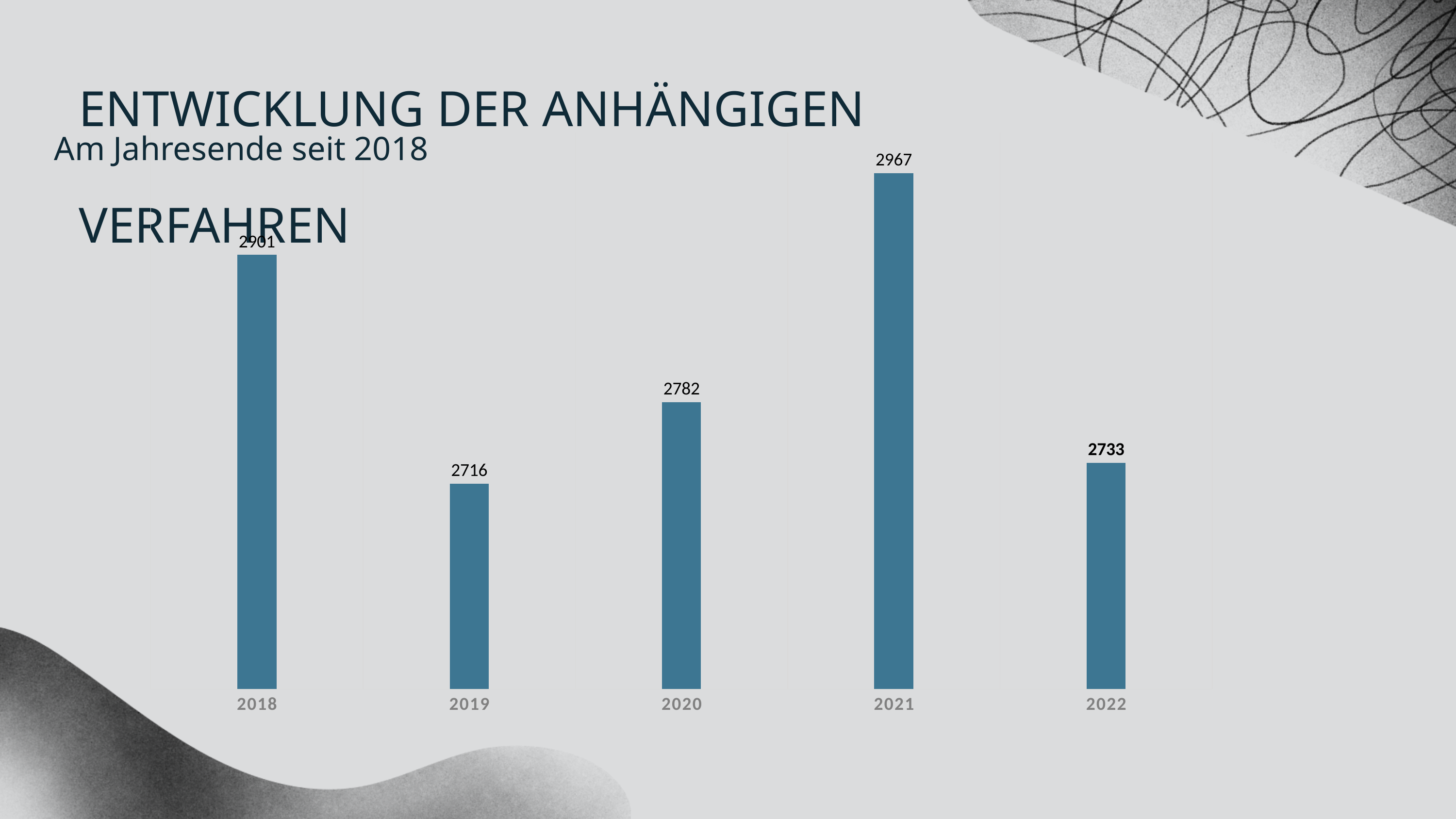
What is the difference between the values for 2022 and 2019? 17 Which year has the lowest value? 2019 What is the value for 2020? 2782 Do the values rise or fall from 2019 to 2021? rise What is the value for 2022? 2733 What is the difference between the values for 2021 and 2020? 185 What is the value for 2021? 2967 Which is larger, the value for 2020 or the value for 2022? 2020 What is the value for 2019? 2716 What kind of chart is shown on the slide? bar chart How many years are shown on the x axis? 5 Which year has the highest value? 2021